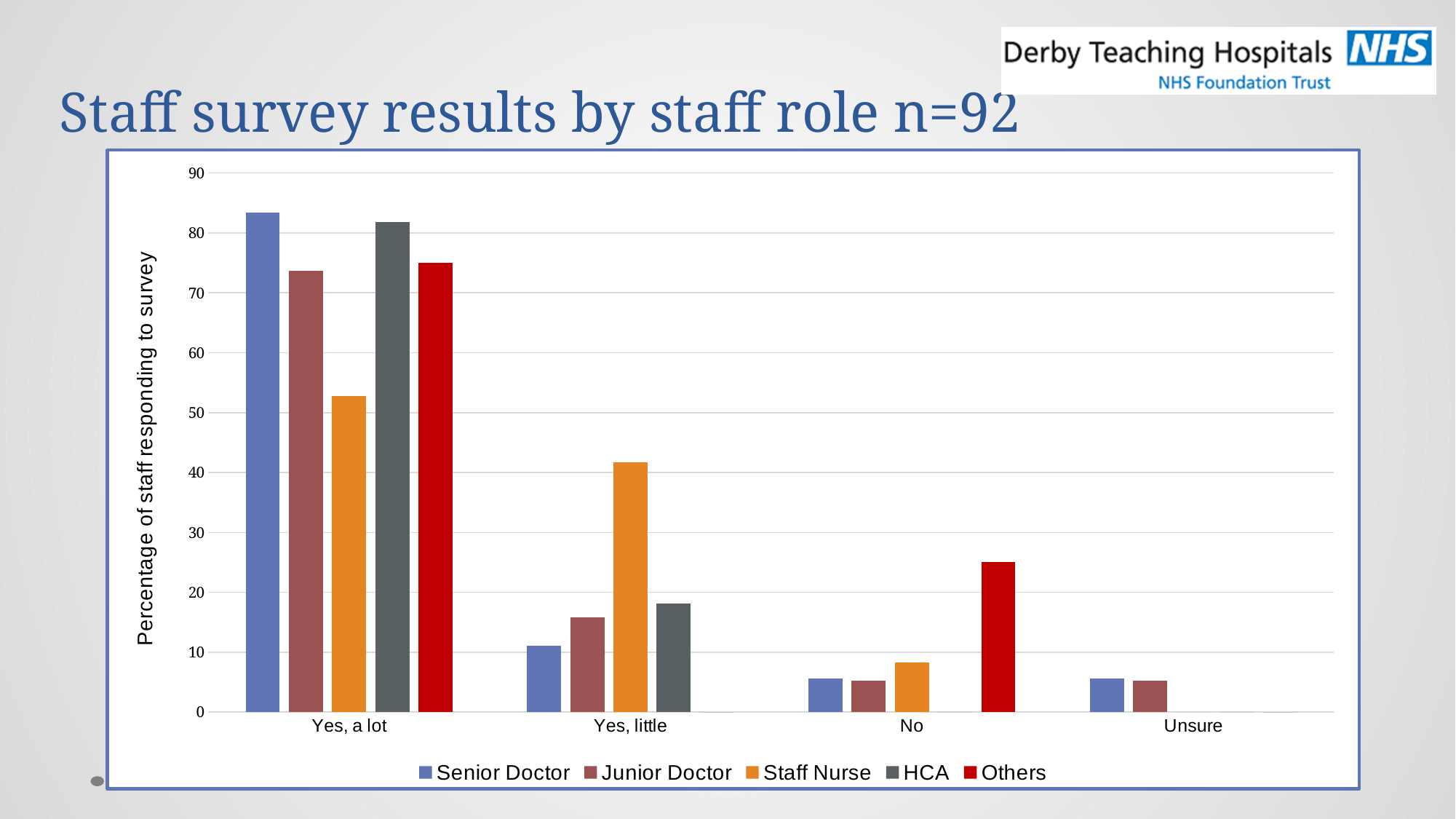
What is the label on the vertical axis? Percentage of staff responding to survey Is the value for Senior Doctor in 'Yes, a lot' greater or less than 80? greater Which staff role has the highest value for 'No'? Others How many response categories are shown on the x axis? 4 Is the value for Others in 'No' greater or less than 20? greater How many series does the legend list? 5 Which is larger for 'Yes, little': HCA or Senior Doctor? HCA Which staff role has the highest value for 'Yes, little'? Staff Nurse What kind of chart is shown on the slide? bar chart Is the value for Staff Nurse in 'Yes, little' greater or less than 40? greater Which is larger for 'Yes, a lot': Junior Doctor or Staff Nurse? Junior Doctor Which staff role has the lowest value for 'Yes, a lot'? Staff Nurse